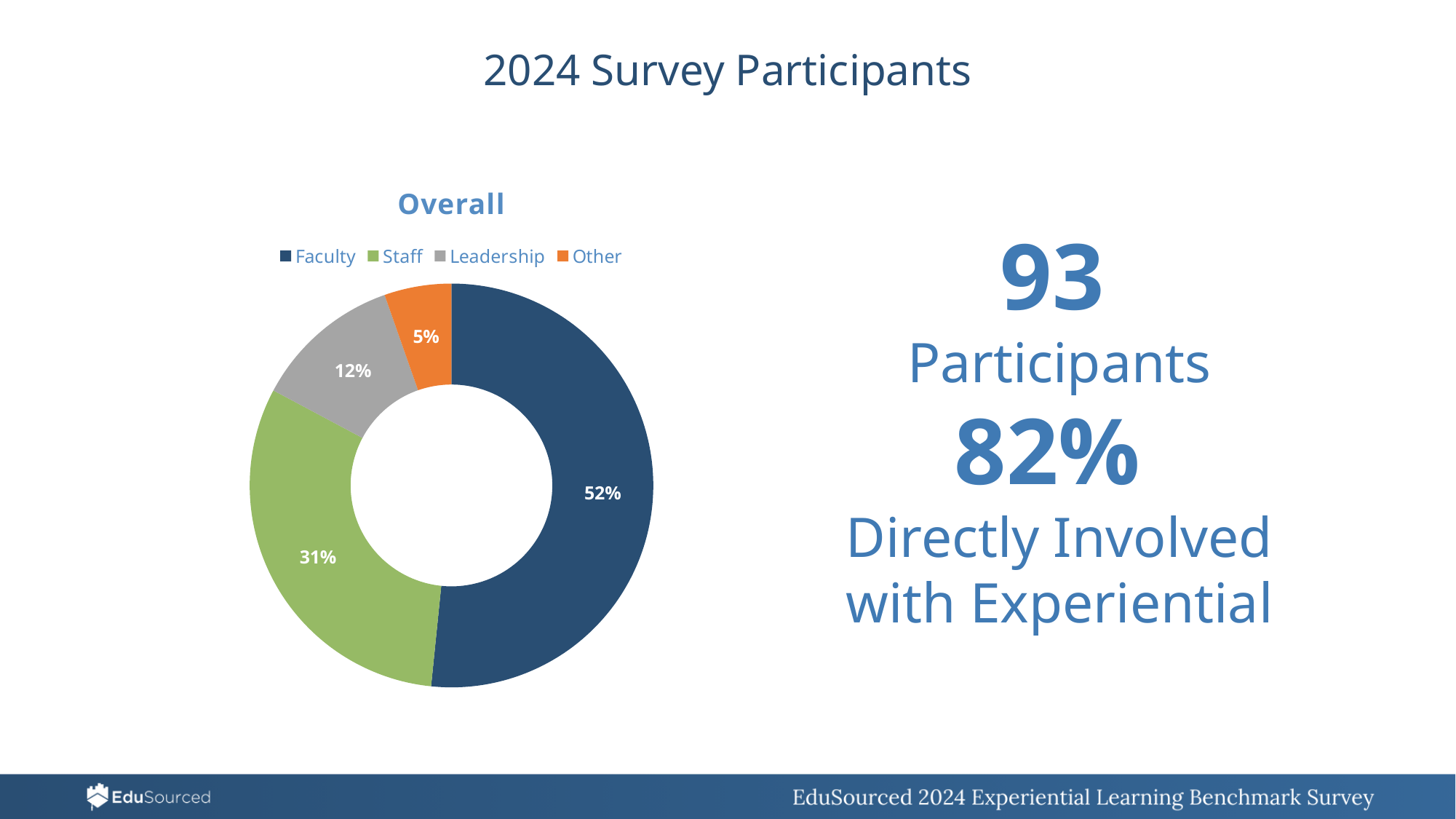
What share of the Overall chart is Staff? 31% What share of the Overall chart is Faculty? 52% What is the title of the chart on the slide? Overall What share of the Overall chart is Leadership? 12% Which is larger in the Overall chart, Leadership or Other? Leadership What colour represents Staff in the Overall chart? Green Which category has the largest slice in the Overall chart? Faculty What kind of chart is the Overall chart? Pie chart (doughnut) How many categories does the Overall chart show? 4 What is the difference in percentage points between Faculty and Staff in the Overall chart? 21 Which category has the smallest slice in the Overall chart? Other